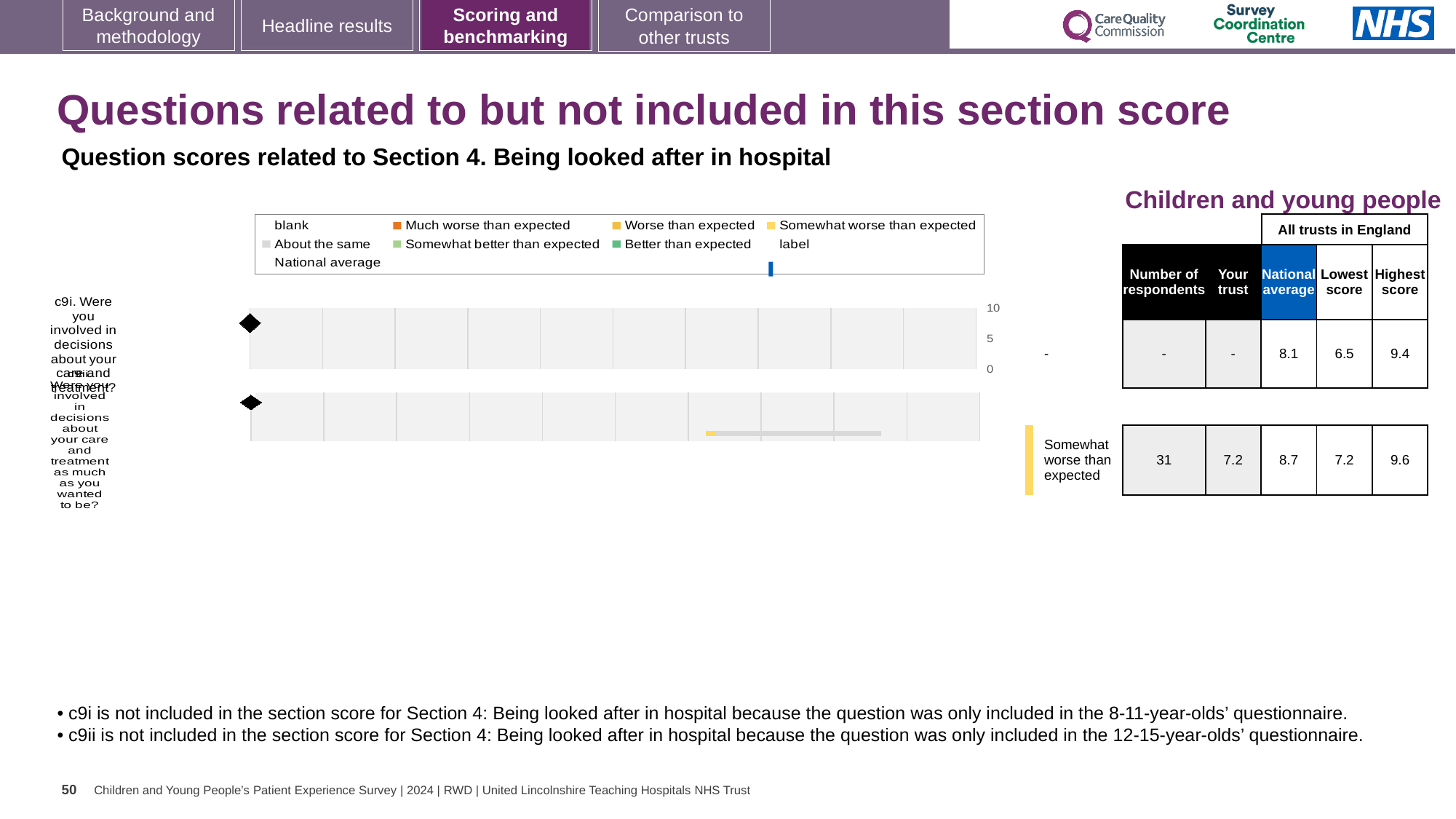
What is the highest value shown on the chart's axis? 10 In the table, what is the 'Your trust' score for c9ii? 7.2 How many questions (categories) are plotted in the chart? 2 In the table, what is the highest score across all trusts in England for c9i? 9.4 In the table, what is the lowest score across all trusts in England for c9i? 6.5 In the table, what is the number of respondents for c9ii (Somewhat worse than expected)? 31 Which question in the chart has a visible plotted bar, c9i or c9ii? c9ii In the table, what is the national average for c9ii? 8.7 Which question has the higher national average in the table, c9i or c9ii? c9ii Is the plotted bar for c9ii greater or less than 5 on the axis? greater What is the difference between the national average (8.7) and the trust score (7.2) for c9ii? 1.5 What kind of chart is shown on the slide? bar chart